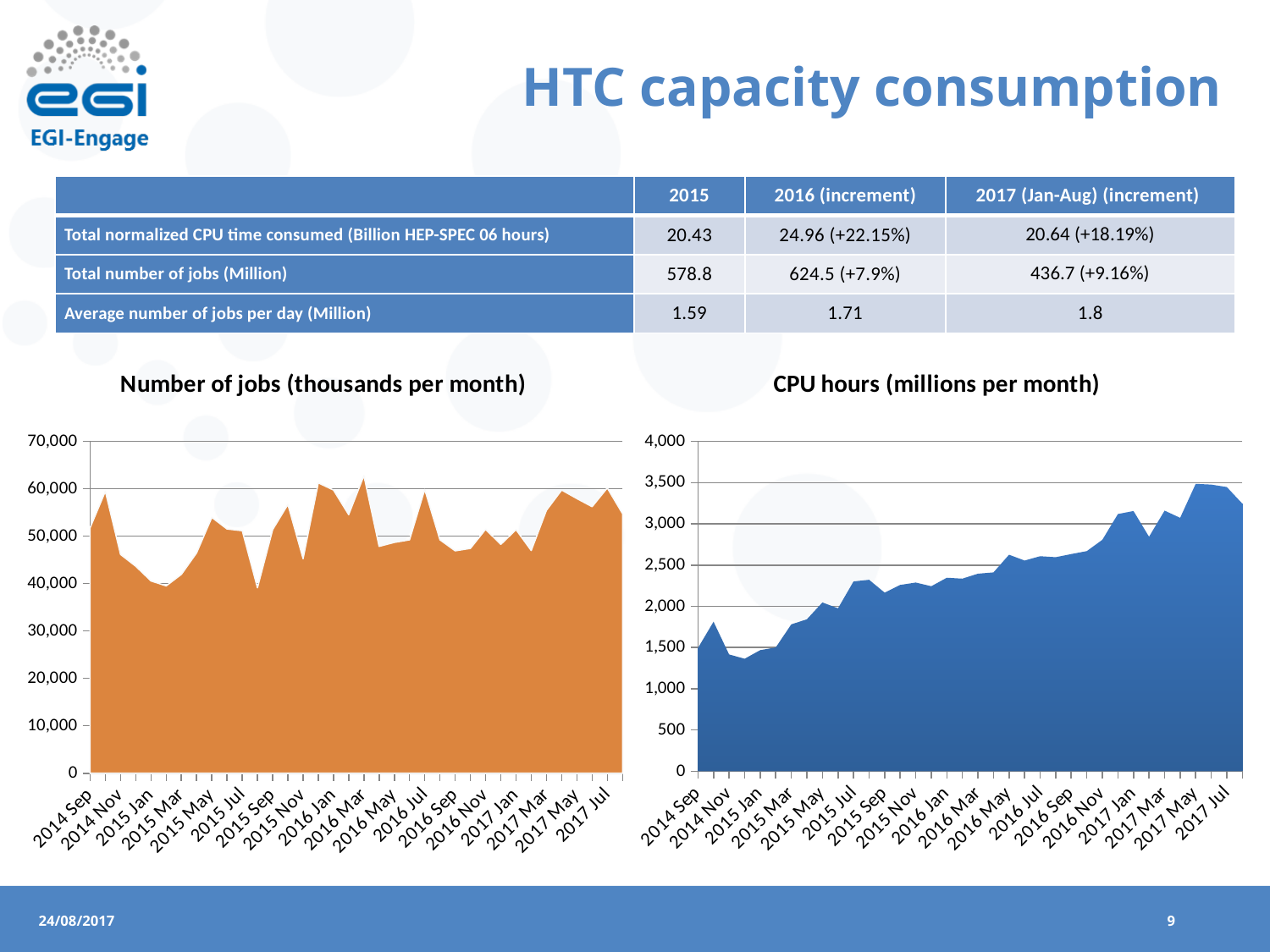
What colour is the area in the 'Number of jobs (thousands per month)' chart? Orange What kind of chart is the 'Number of jobs (thousands per month)' chart? Area chart What kind of chart is the 'CPU hours (millions per month)' chart? Area chart In the 'CPU hours (millions per month)' chart, is the value for 2016 Jan greater or less than 2,000? greater In the 'Number of jobs (thousands per month)' chart, which is larger, the value for 2015 Jan or the value for 2016 Mar? 2016 Mar In the 'CPU hours (millions per month)' chart, do the values generally rise or fall from 2014 Sep to 2017 Jul? Rise What is the title of the chart on the right side of the slide? CPU hours (millions per month) In the 'CPU hours (millions per month)' chart, is the value for 2014 Sep greater or less than 2,000? less In the 'Number of jobs (thousands per month)' chart, is the value for 2016 Mar greater or less than 50,000? greater In the 'CPU hours (millions per month)' chart, which is larger, the value for 2014 Sep or the value for 2017 Jul? 2017 Jul